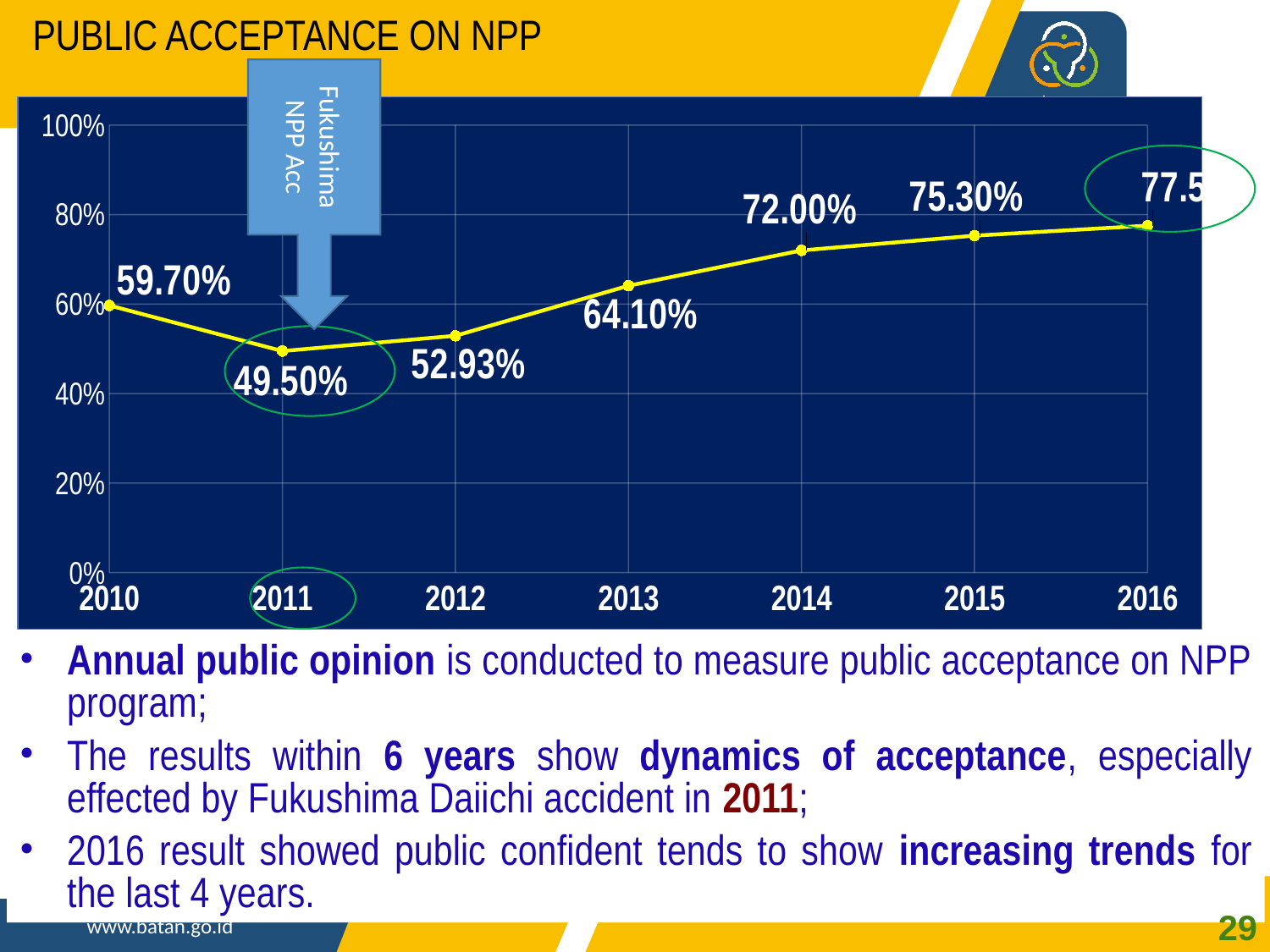
Is the value for 2016 greater or less than 60%? greater What is the public acceptance value for 2015? 75.30% What type of chart is shown on the slide? line chart What is the public acceptance value for 2010? 59.70% By how many percentage points did public acceptance fall from 2010 to 2011? 10.20 percentage points What is the difference between the 2014 and 2013 values? 7.90 percentage points How many years are plotted on the chart? 7 Which year has the lowest public acceptance value? 2011 Which year has the highest public acceptance value? 2016 Which is larger, the value for 2012 or the value for 2014? 2014 What is the public acceptance value for 2011? 49.50% What is the public acceptance value for 2013? 64.10%